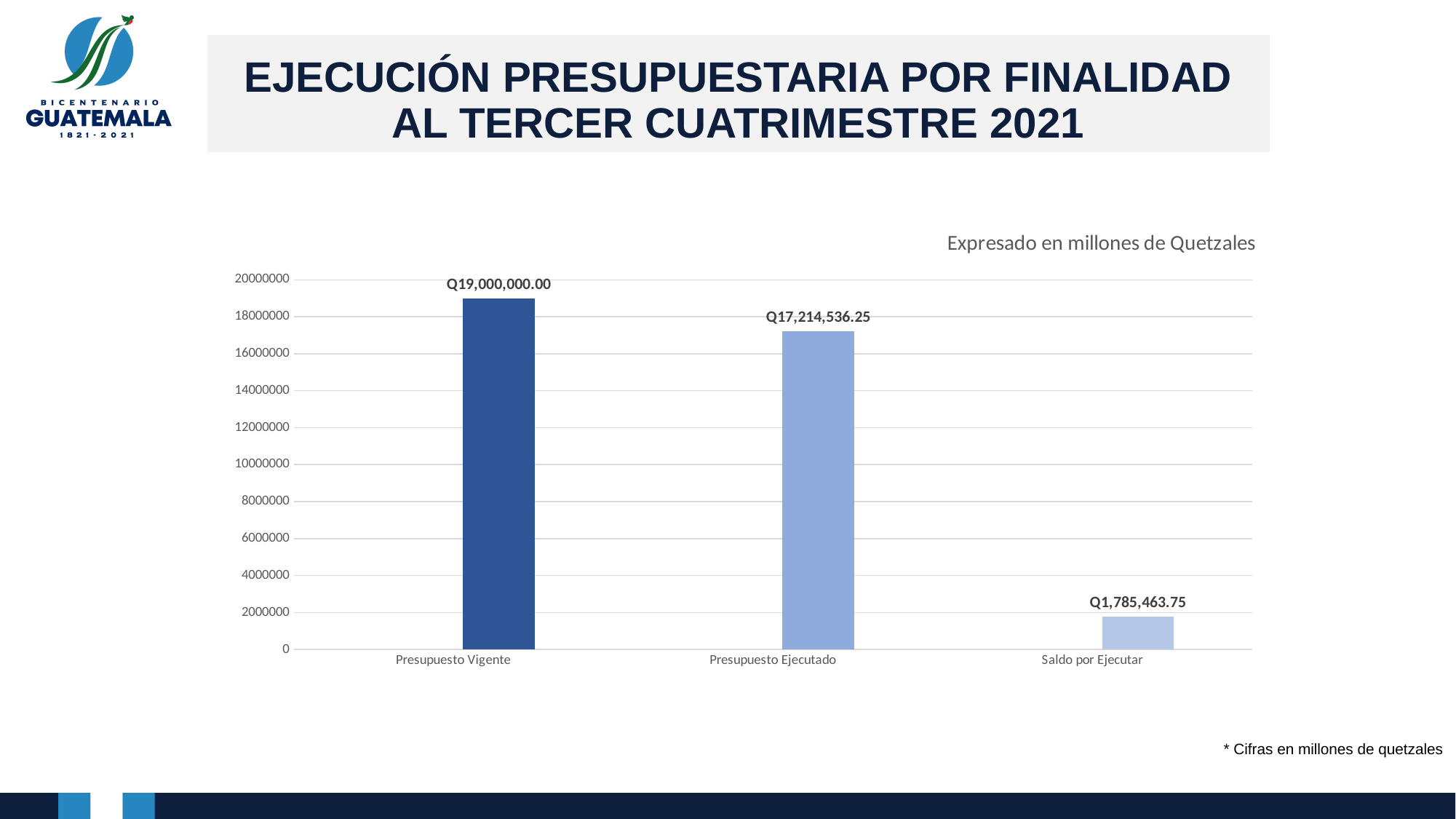
Which category has the lowest value? Saldo por Ejecutar What is the difference between Presupuesto Ejecutado and Saldo por Ejecutar? Q15,429,072.50 Is the value for Presupuesto Ejecutado greater or less than 16000000? greater What is the value for Presupuesto Vigente? Q19,000,000.00 What is the difference between Presupuesto Vigente and Presupuesto Ejecutado? Q1,785,463.75 What is the value for Presupuesto Ejecutado? Q17,214,536.25 What kind of chart is shown on the slide? Bar chart Which category has the highest value? Presupuesto Vigente Which is larger, Presupuesto Ejecutado or Saldo por Ejecutar? Presupuesto Ejecutado How many categories are shown in the chart? 3 What is the value for Saldo por Ejecutar? Q1,785,463.75 Is the value for Saldo por Ejecutar greater or less than 2000000? less